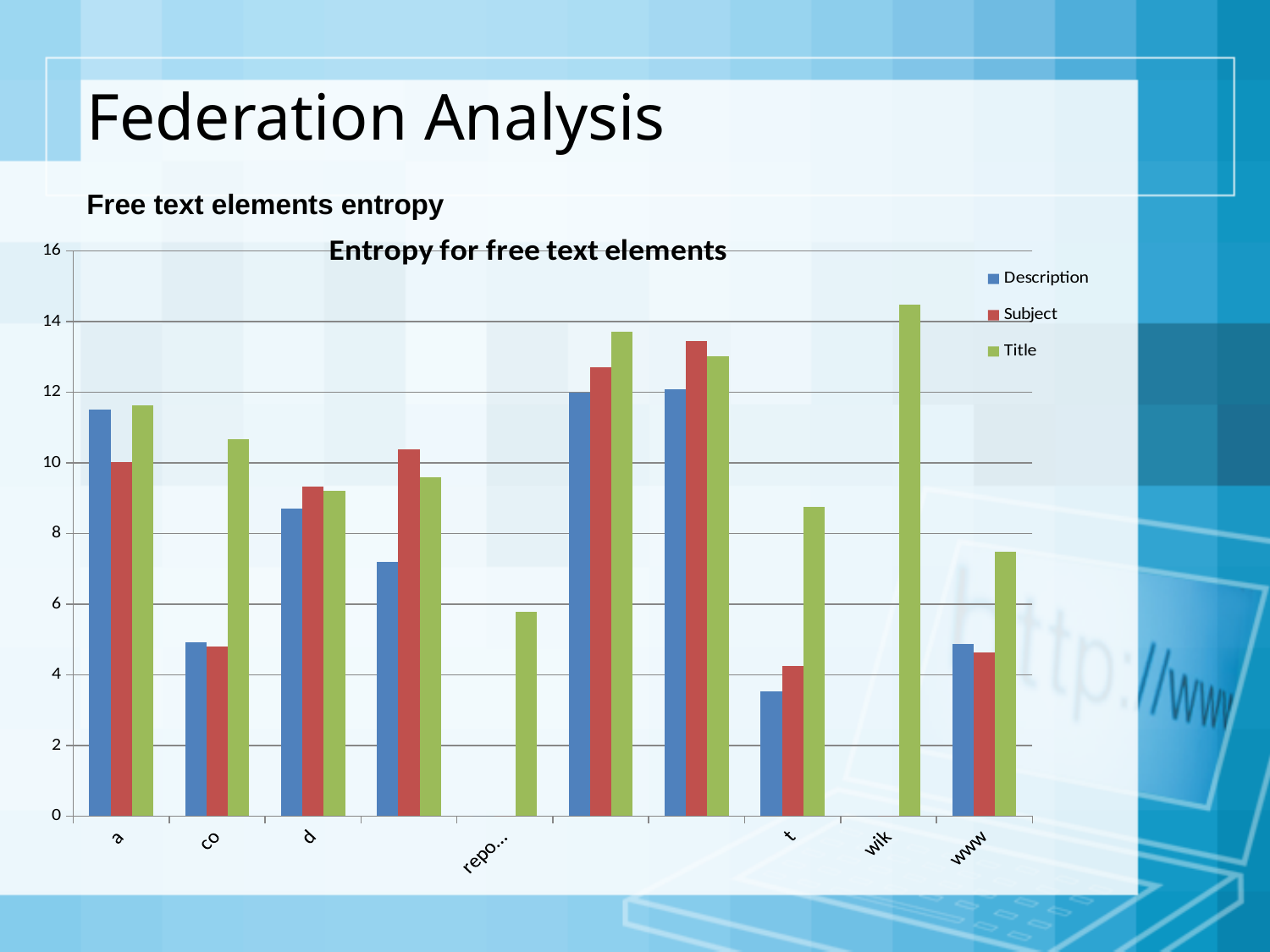
Is the Title value for repo... greater or less than 8? less For category a, which is larger: the Description value or the Subject value? Description Which category has the highest Title value? wik For category t, which series has the highest value? Title Is the Title value for co greater or less than 10? greater Which series are listed in the chart legend? Description, Subject, Title Is the Title value for www greater or less than 6? greater What is the title of the chart? Entropy for free text elements How many series does the legend of the chart list? 3 What kind of chart is shown on the slide? bar chart